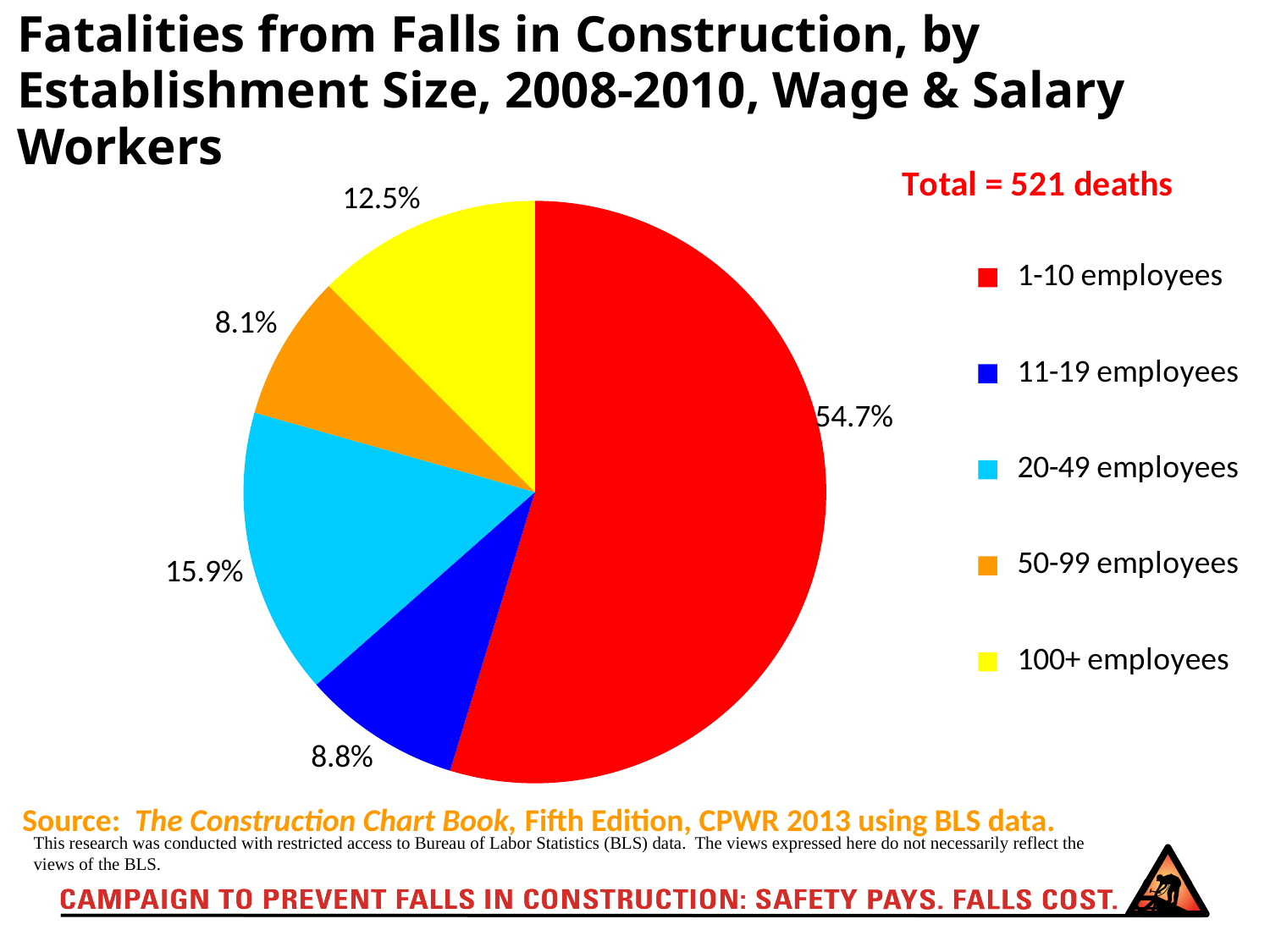
Which establishment size category has the largest share of fatalities? 1-10 employees What share is shown for the 100+ employees category? 12.5% What is the difference in percentage points between the 1-10 employees slice and the 20-49 employees slice? 38.8 Which establishment size category has the smallest share of fatalities? 50-99 employees Which has a larger share: 11-19 employees or 100+ employees? 100+ employees What type of chart is shown on the slide? Pie chart What colour represents the 50-99 employees category in the pie chart? Orange What total number of deaths is stated on the slide? 521 deaths What percentage is shown for establishments with 11-19 employees? 8.8% What percentage of the pie is the 20-49 employees slice? 15.9% How many categories does the pie chart show? 5 What share of fatalities from falls is attributed to establishments with 1-10 employees? 54.7%